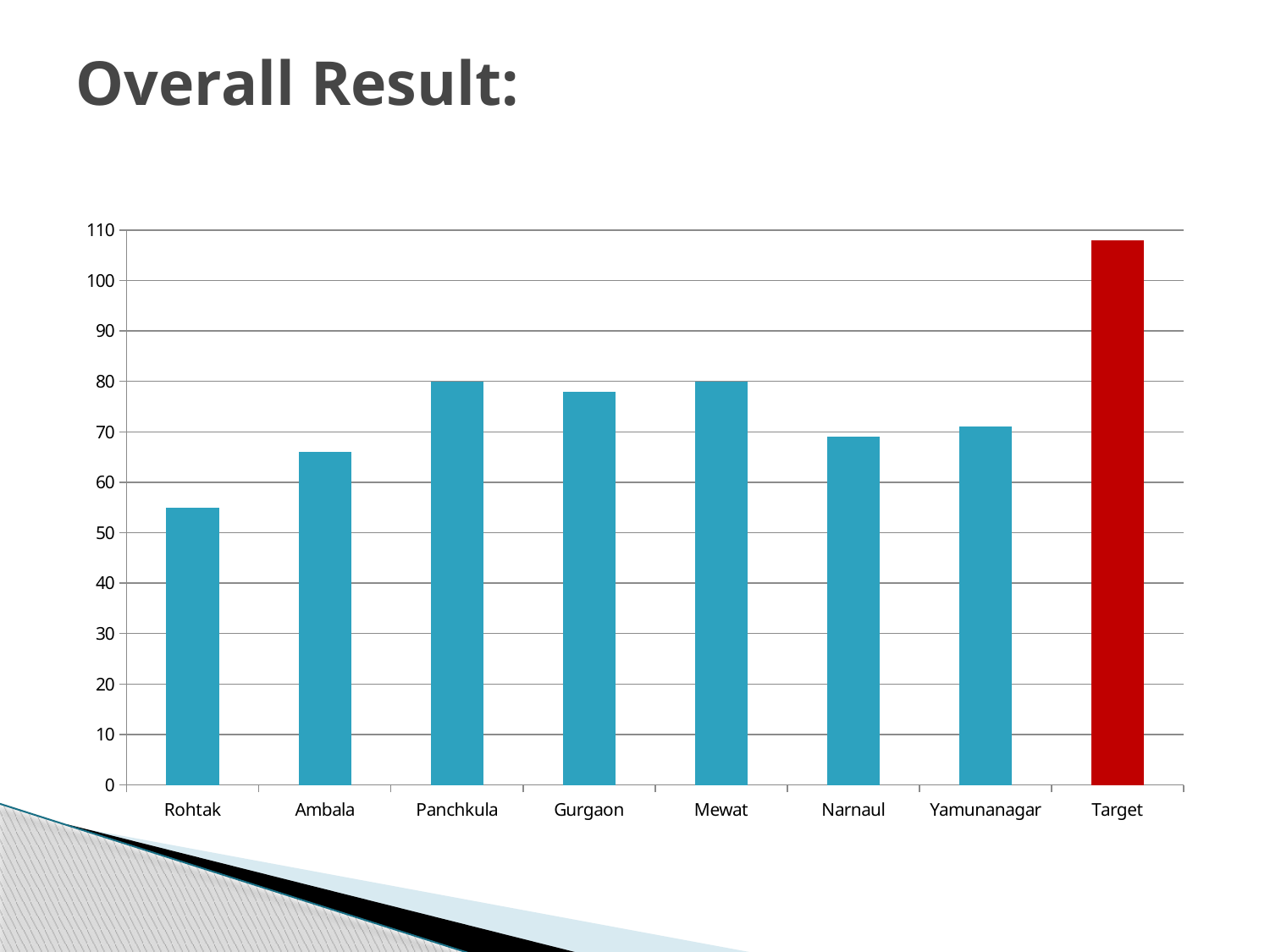
Is the value for Rohtak greater or less than 60? less What kind of chart is shown on the slide? bar chart Is the value for Ambala greater or less than 60? greater Is the value for Target greater or less than 100? greater Which is larger, the value for Rohtak or the value for Ambala? Ambala Which category has the highest bar in the chart? Target How many categories are shown on the x axis of the chart? 8 Which category has the lowest bar in the chart? Rohtak Which is larger, the value for Panchkula or the value for Narnaul? Panchkula What colour is the Target bar in the chart? red